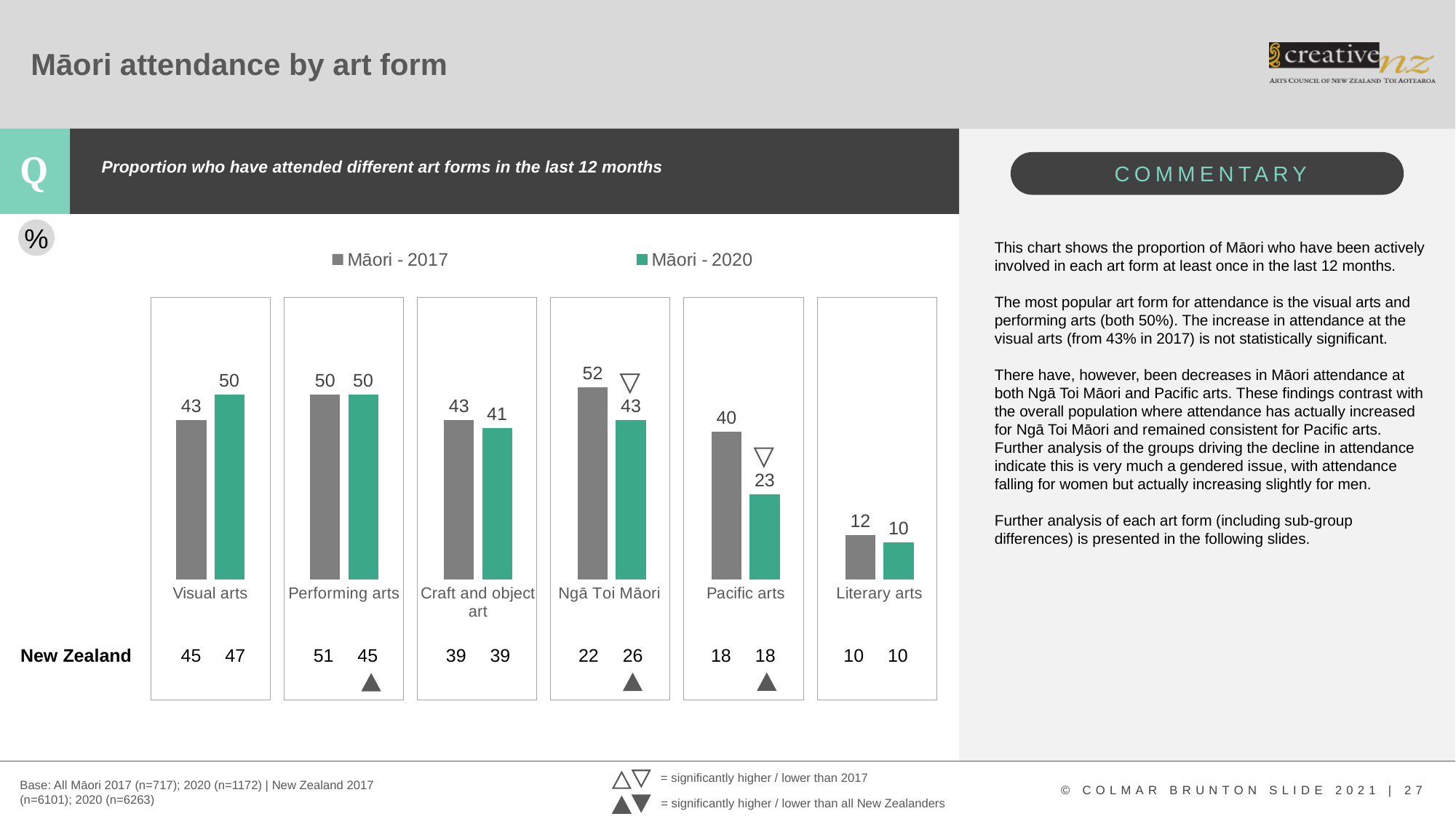
For Craft and object art, which is larger: the Māori - 2017 value or the Māori - 2020 value? Māori - 2017 How many art form categories are shown in the chart? 6 What is the value for Māori - 2017 for Literary arts? 12 Which colour represents the Māori - 2020 series in the chart? Green Which art form has the lowest value for Māori - 2020? Literary arts Which art form has the highest value for Māori - 2017? Ngā Toi Māori What is the difference between the Māori - 2017 and Māori - 2020 values for Pacific arts? 17 What kind of chart is shown on the slide? Bar chart What is the value for Māori - 2017 for Ngā Toi Māori? 52 What is the value for Māori - 2020 for Pacific arts? 23 What is the value for Māori - 2020 for Visual arts? 50 How many series does the legend list? 2